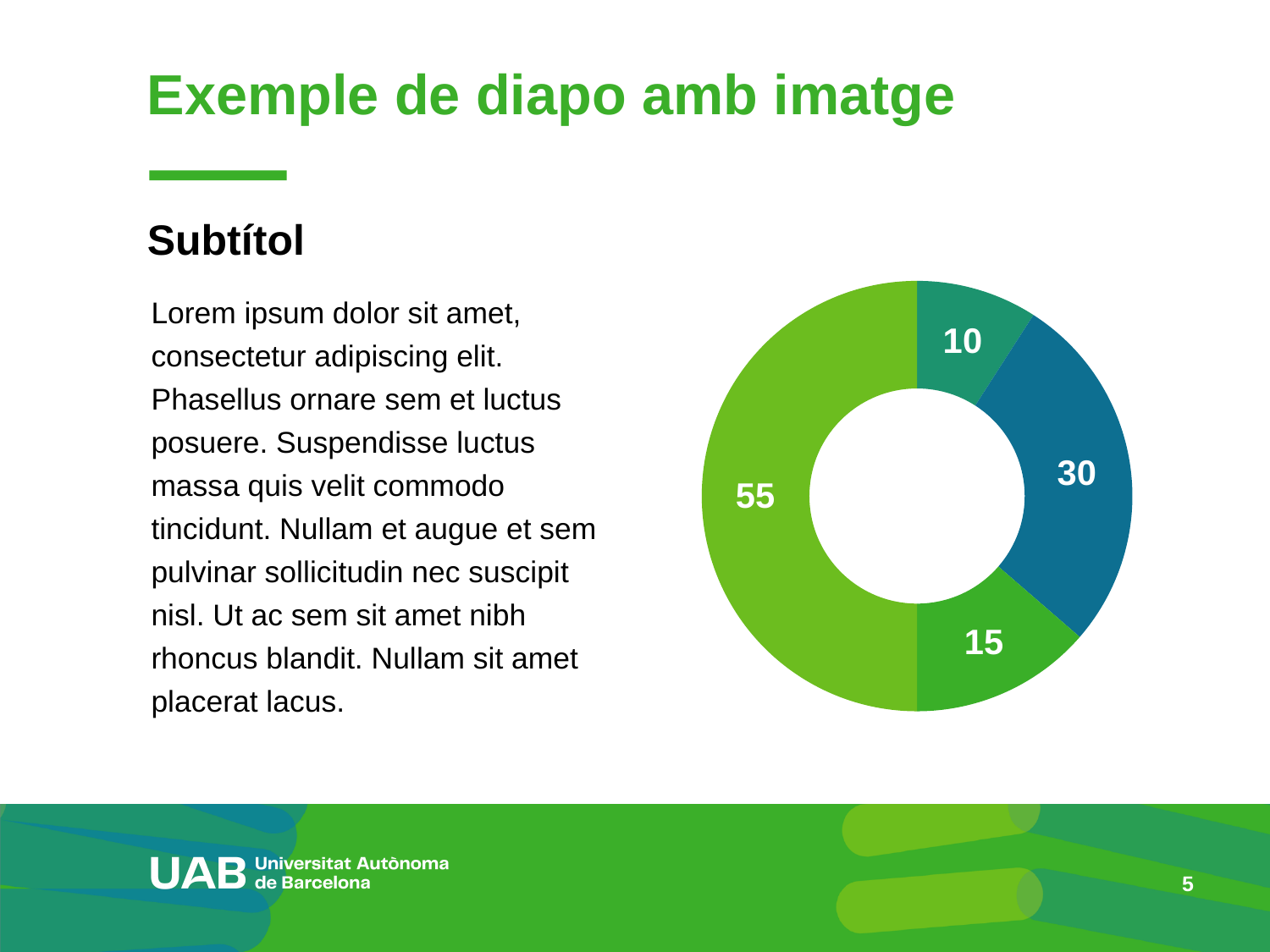
What is the value of the smallest slice in the doughnut chart? 10 How many slices does the doughnut chart have? 4 What value is shown on the dark blue slice of the doughnut chart? 30 What is the difference between the slice labelled 15 and the slice labelled 10? 5 Which is larger, the dark blue slice or the slice labelled 15? The dark blue slice (30) What value is shown on the light green slice on the left side of the doughnut chart? 55 What is the value of the largest slice in the doughnut chart? 55 What value is shown on the slice at the bottom right of the doughnut chart? 15 What is the difference between the largest slice (55) and the dark blue slice (30)? 25 What share of the doughnut chart does the slice labelled 55 represent? 50% What kind of chart is shown on the slide? Doughnut chart What is the sum of all four slice values in the doughnut chart? 110